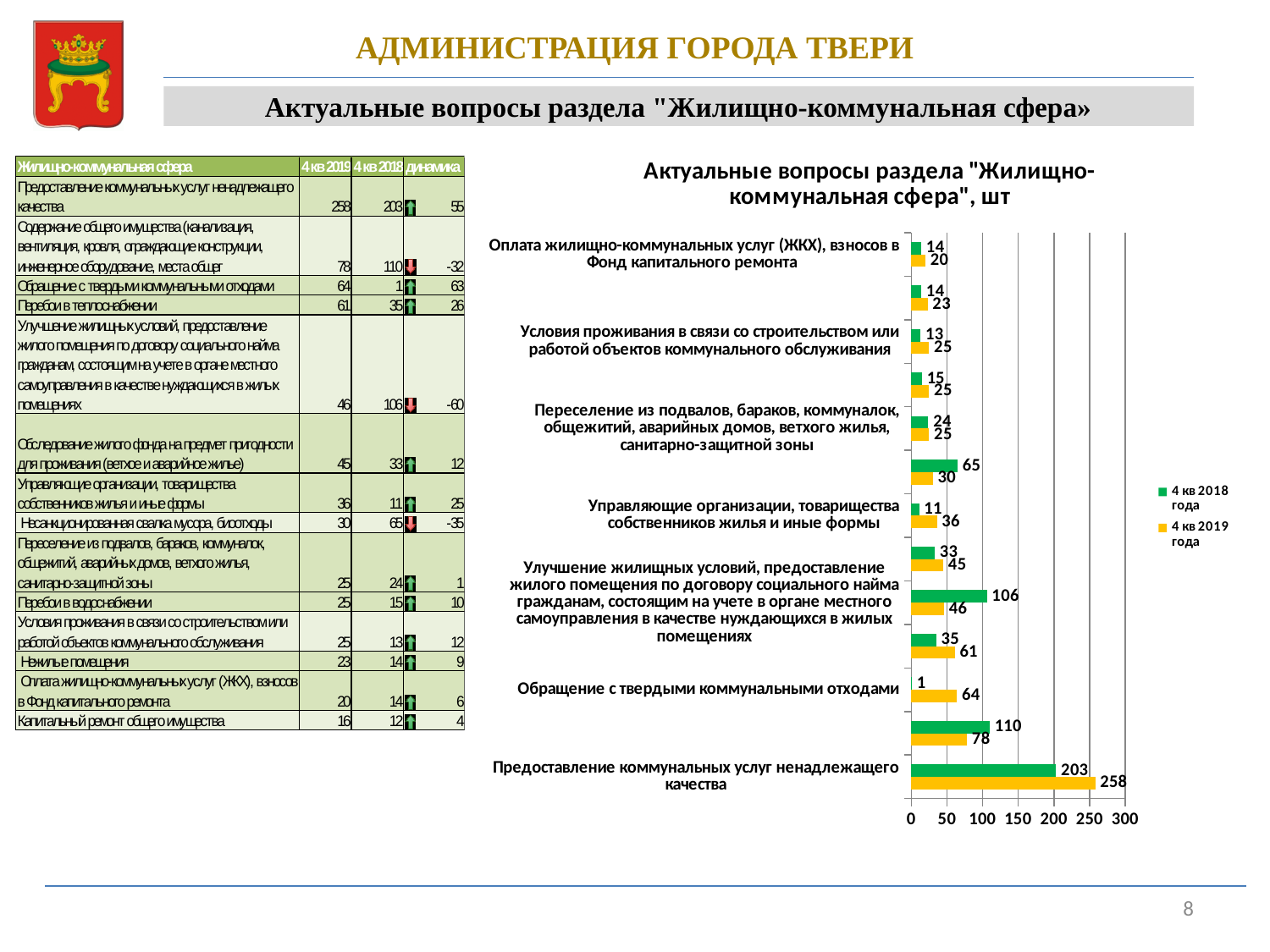
For "Улучшение жилищных условий, предоставление жилого помещения по договору социального найма...", which series has the larger value, 4 кв 2018 года or 4 кв 2019 года? 4 кв 2018 года What is the value for 4 кв 2019 года for "Управляющие организации, товарищества собственников жилья и иные формы"? 36 What is the value for 4 кв 2018 года for "Оплата жилищно-коммунальных услуг (ЖКХ), взносов в Фонд капитального ремонта"? 14 Which category has the highest value for 4 кв 2019 года? Предоставление коммунальных услуг ненадлежащего качества Which series is shown in green in the chart? 4 кв 2018 года What is the difference between the 4 кв 2019 года and 4 кв 2018 года values for "Обращение с твердыми коммунальными отходами"? 63 What is the difference between the 4 кв 2019 года and 4 кв 2018 года values for "Предоставление коммунальных услуг ненадлежащего качества"? 55 What is the value for 4 кв 2019 года for "Предоставление коммунальных услуг ненадлежащего качества"? 258 What kind of chart is shown on the slide? bar chart What is the difference between the 4 кв 2018 года and 4 кв 2019 года values for "Улучшение жилищных условий, предоставление жилого помещения по договору социального найма..."? 60 How many series does the chart legend list? 2 What is the value for 4 кв 2018 года for "Обращение с твердыми коммунальными отходами"? 1